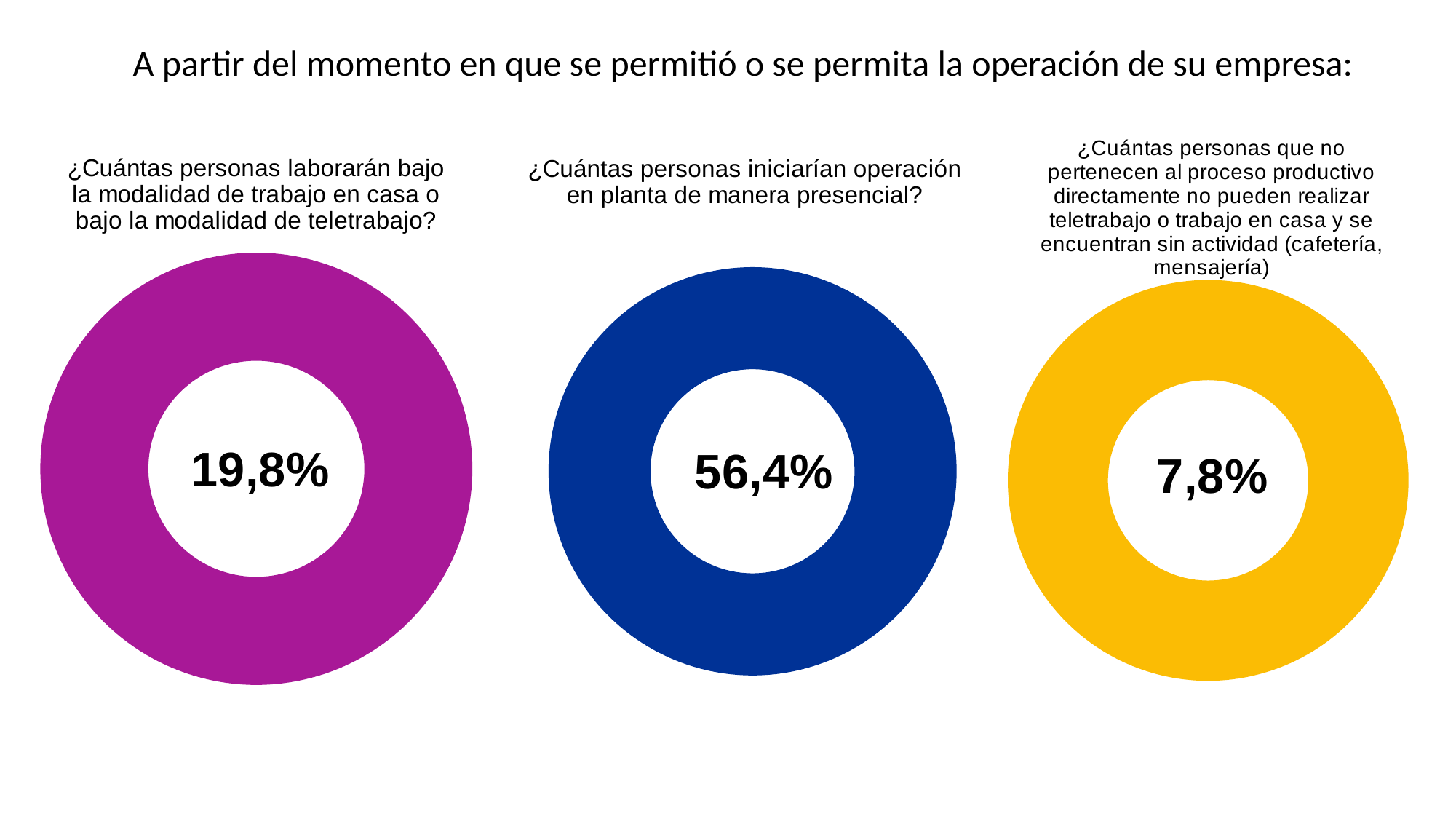
Which of the three charts shows the lowest percentage? The right chart (people without activity), 7,8% What is the difference between the middle chart's value (56,4%) and the left chart's value (19,8%)? 36,6% Which of the three charts shows the highest percentage? The middle chart (in-person plant operation), 56,4% Is the value on the middle chart larger or smaller than the value on the left chart? Larger What is the difference between the middle chart's value (56,4%) and the right chart's value (7,8%)? 48,6% What kind of chart is used for each of the three figures on the slide? Donut chart What colour is the donut chart showing 56,4%? Blue What is the difference between the left chart's value (19,8%) and the right chart's value (7,8%)? 12,0% On the left chart, what percentage of people will work from home or under teleworking? 19,8% How many donut charts are shown on the slide? 3 On the right chart, what percentage of people not belonging to the production process are without activity? 7,8% On the middle chart, what percentage of people would start operating in the plant in person? 56,4%